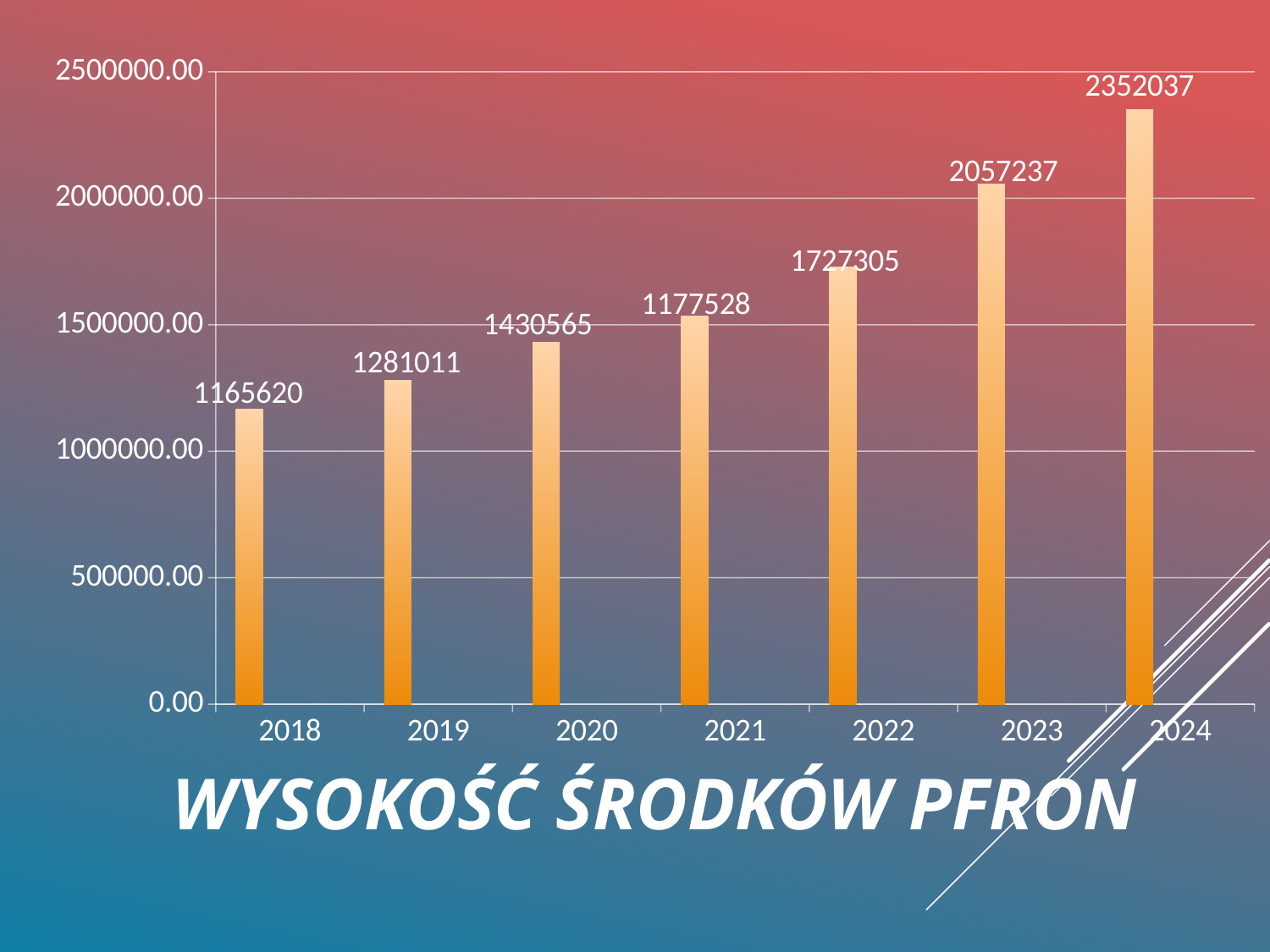
What is the value for 2018? 1165620 What is the value for 2020? 1430565 Is the value for 2022 greater or less than 1500000? greater What kind of chart is shown on the slide? bar chart How many years are shown on the x axis? 7 Which is larger, the value for 2023 or the value for 2022? 2023 What is the difference between the values for 2024 and 2023? 294800 What is the title of the chart? WYSOKOŚĆ ŚRODKÓW PFRON What is the value for 2024? 2352037 What is the value for 2022? 1727305 What is the difference between the values for 2019 and 2018? 115391 Which year has the highest value? 2024